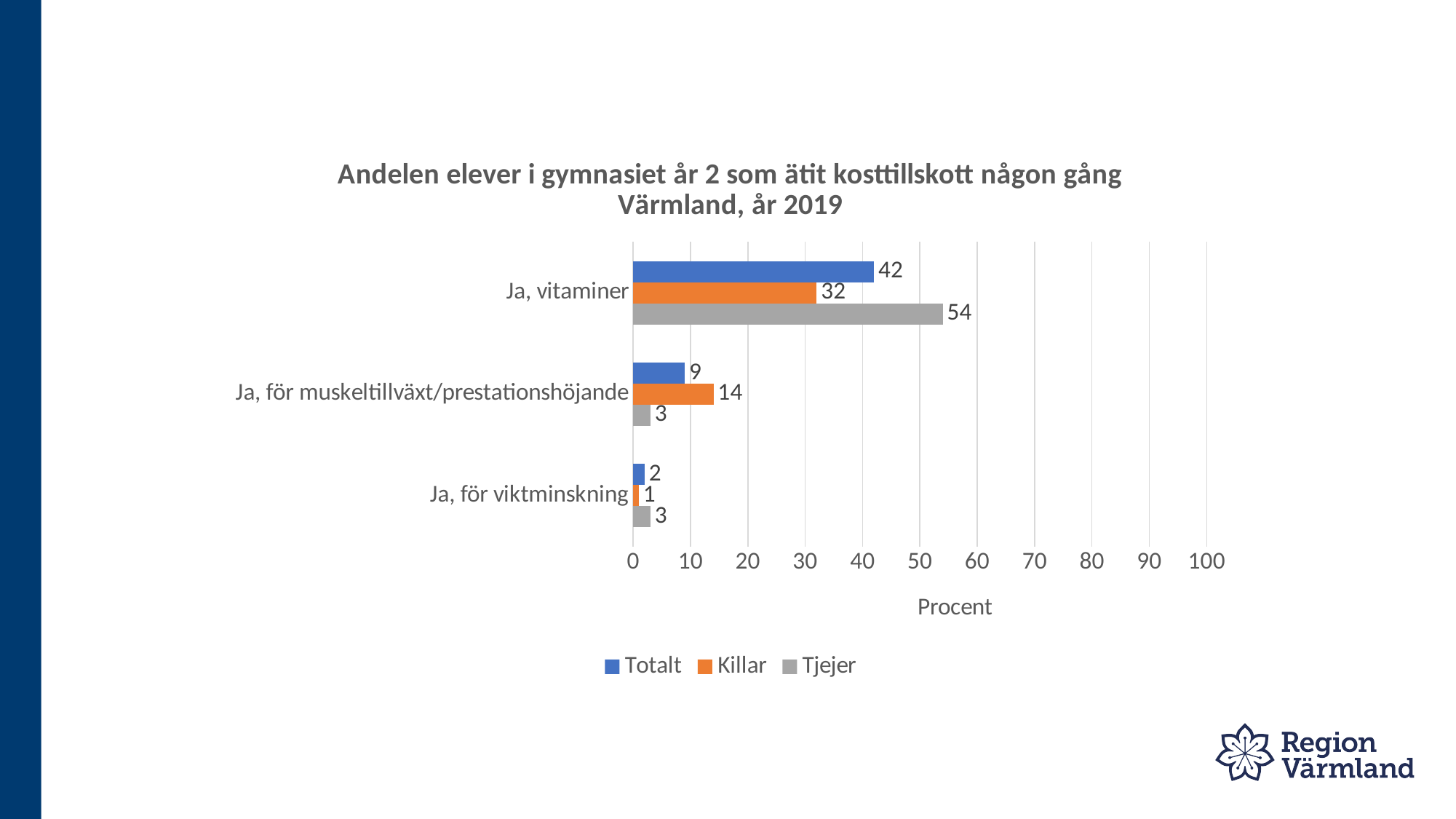
What is the value for Killar in the 'Ja, för muskeltillväxt/prestationshöjande' category? 14 For 'Ja, för muskeltillväxt/prestationshöjande', which is larger: Killar or Tjejer? Killar How many series does the legend list? 3 What is the value for Tjejer in the 'Ja, vitaminer' category? 54 Which category has the highest Totalt value? Ja, vitaminer Which category has the lowest Killar value? Ja, för viktminskning Is the Tjejer value for 'Ja, vitaminer' greater or less than 50? greater How many categories are shown on the chart? 3 What is the Totalt value for 'Ja, för viktminskning'? 2 What is the difference between the Tjejer and Killar values for 'Ja, vitaminer'? 22 What kind of chart is shown on the slide? Bar chart What is the label of the x axis? Procent